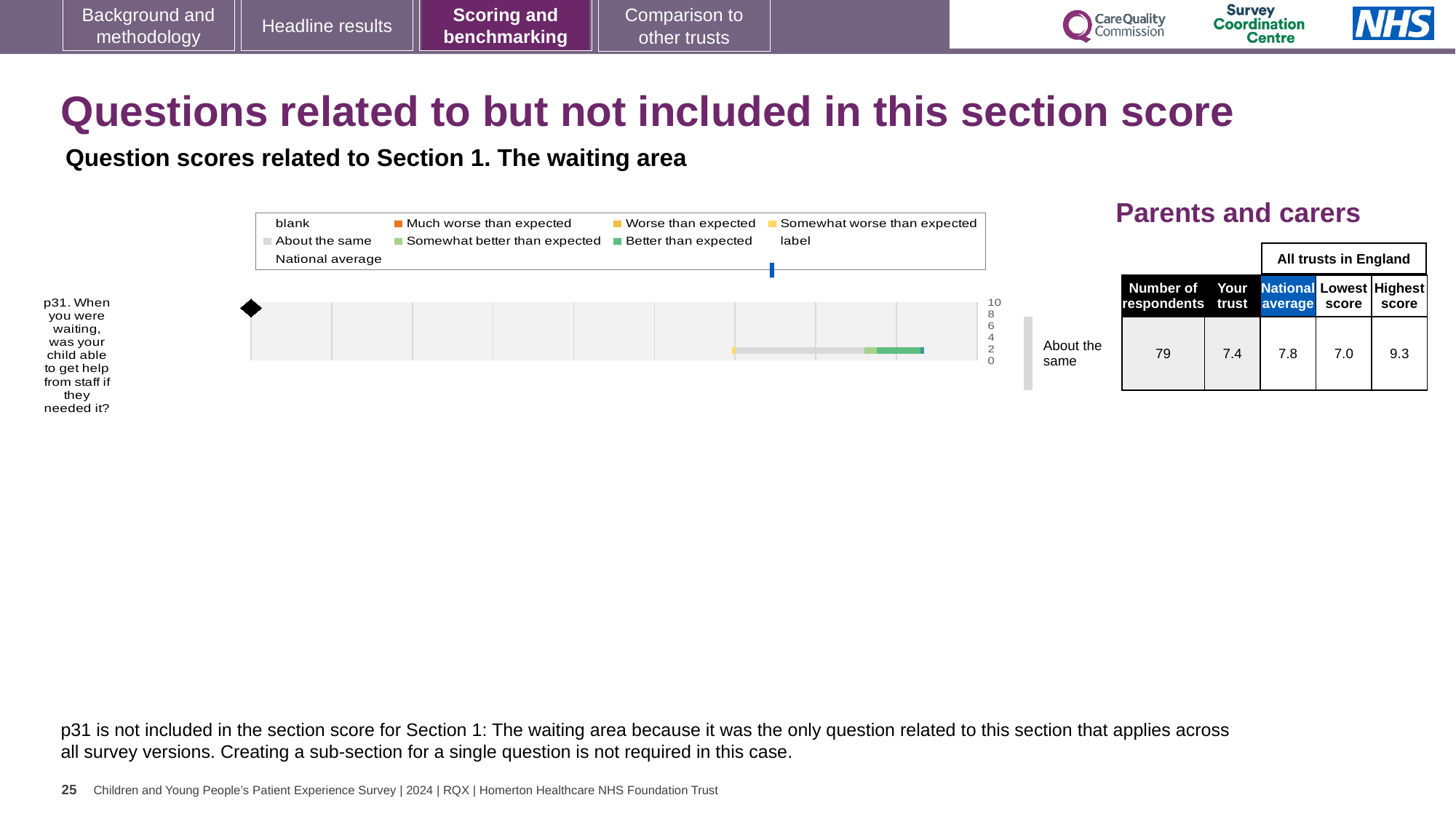
How many survey questions are plotted in the chart? 1 What colour does the legend use for 'Much worse than expected'? orange In the table beside the chart, what is the national average score for p31? 7.8 In the table beside the chart, what is the highest score among all trusts in England for p31? 9.3 In the table beside the chart, what is the lowest score among all trusts in England for p31? 7.0 In the table beside the chart, how many respondents answered p31? 79 What kind of chart is used to show the p31 question score? bar chart In the table beside the chart, what is the 'Your trust' score for p31? 7.4 For p31, which is larger: the 'Your trust' score or the national average? National average For p31, what is the difference between the highest score and the lowest score among all trusts in England? 2.3 What is the highest value shown on the chart's score axis? 10 What rating label is shown beside the chart for question p31? About the same